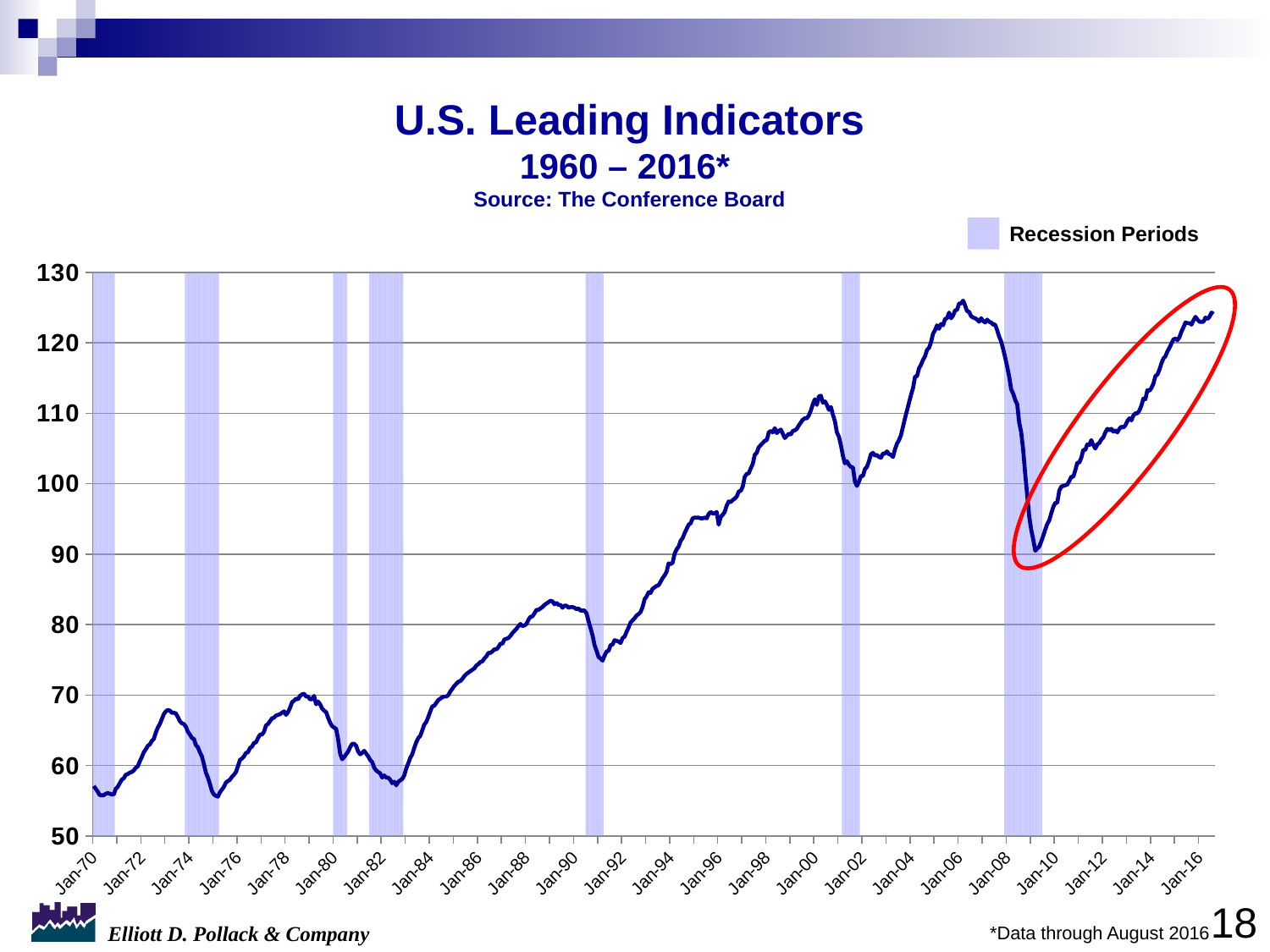
What is the title of the chart? U.S. Leading Indicators 1960 – 2016* What does the shaded legend entry represent? Recession Periods Is the value at Jan-98 greater or less than 100? greater Is the value at Jan-70 greater or less than 60? less Is the value at Jan-10 greater or less than 100? less How many entries does the legend list? 1 What kind of chart is shown on the slide? line chart Does the line overall rise or fall from Jan-70 to Jan-16? rise Does the line rise or fall between Jan-08 and Jan-10? fall How many shaded recession periods are shown on the chart? 7